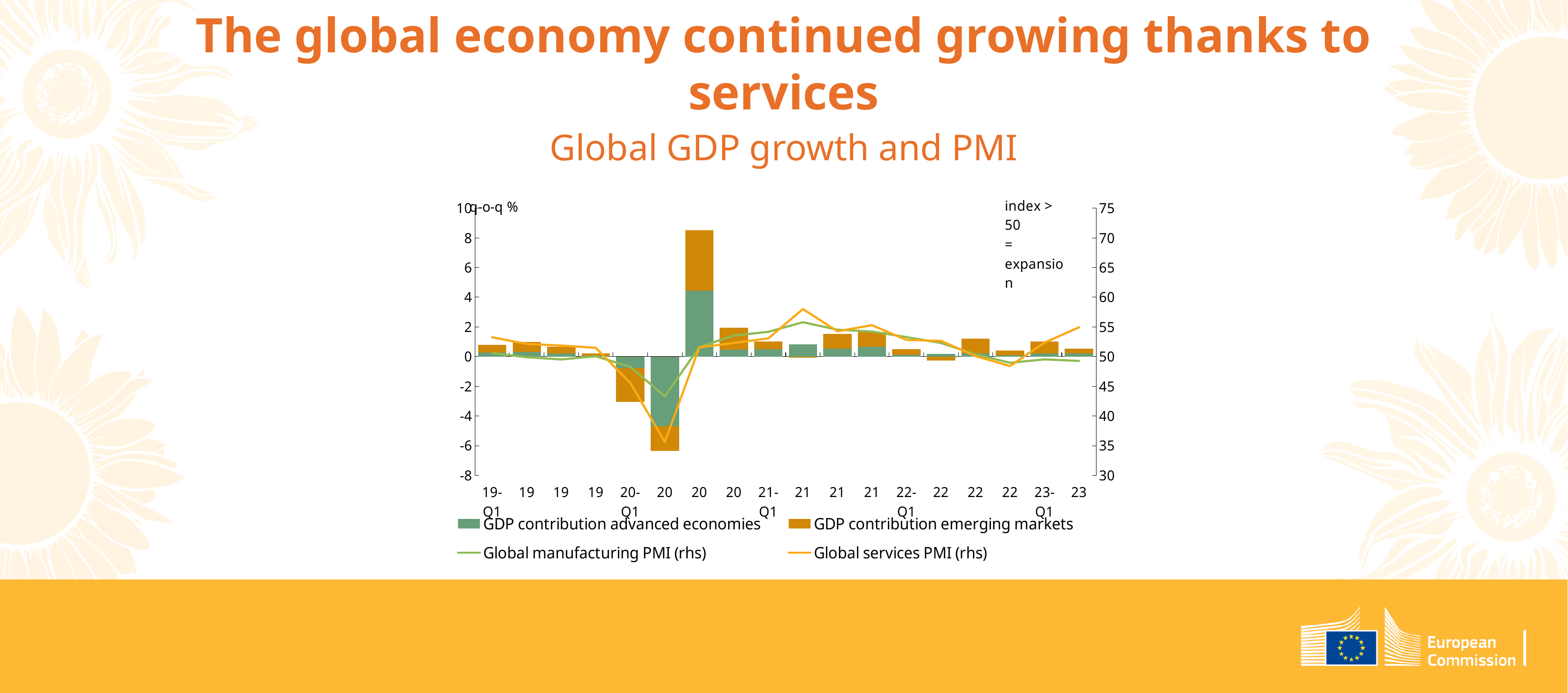
In which quarter is the stacked GDP growth bar highest? 20 Q3 (the third 20 bar) How many quarters are plotted along the x axis? 18 Which legend entry is drawn as a green bar? GDP contribution advanced economies In which quarter is the stacked GDP growth bar lowest? 20 Q2 (the bar after 20-Q1) Is the total stacked GDP growth bar for 20 Q2 greater or less than -4? less Is the Global services PMI value at 20 Q2 greater or less than 40? less What kind of chart is shown on the slide? A combination chart with stacked bars and lines At 21 Q2, which line is higher: Global services PMI or Global manufacturing PMI? Global services PMI How many series does the legend list? 4 What is the title of the chart? Global GDP growth and PMI Does the Global services PMI line rise or fall between 22 Q4 and 23 Q2? rise Is the total stacked GDP growth bar for 20 Q3 greater or less than 6? greater